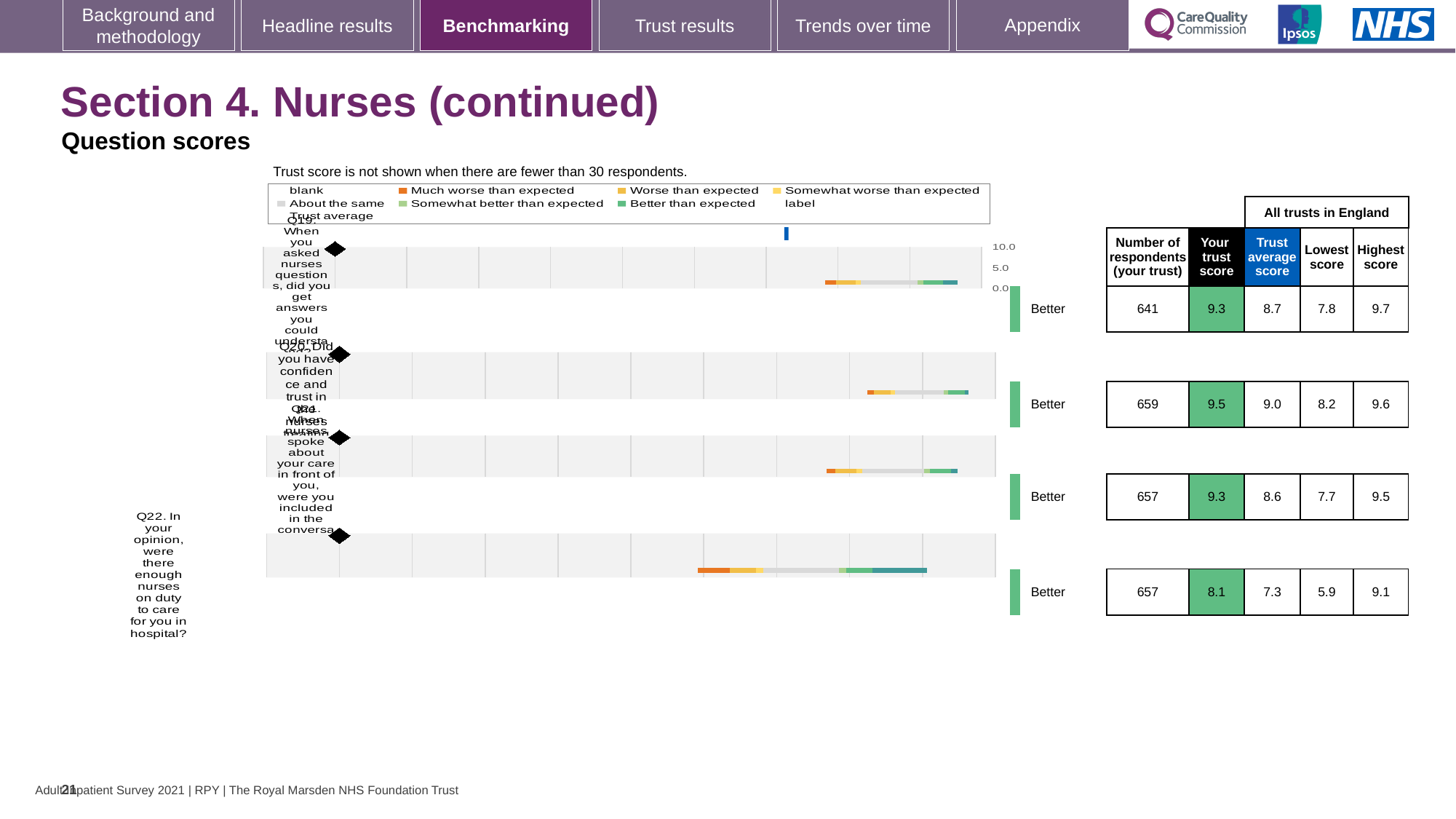
How many respondents from your trust answered Q19? 641 Which question has the lowest 'Your trust score'? Q22 How many questions are plotted in the question scores chart? 4 What word is printed next to the green marker beside each question's bar? Better For Q22, what is the difference between 'Your trust score' and the 'Trust average score'? 0.8 What is the 'Trust average score' for Q20 (confidence and trust in nurses)? 9.0 Which question has the highest 'Your trust score'? Q20 What is the 'Highest score' across all trusts in England for Q22? 9.1 What is the 'Your trust score' for Q22 (were there enough nurses on duty)? 8.1 For Q19, which is larger: 'Your trust score' or the 'Trust average score'? Your trust score For Q22, what is the difference between the 'Highest score' and the 'Lowest score' across all trusts in England? 3.2 What kind of chart is used to show the question scores on this slide? bar chart